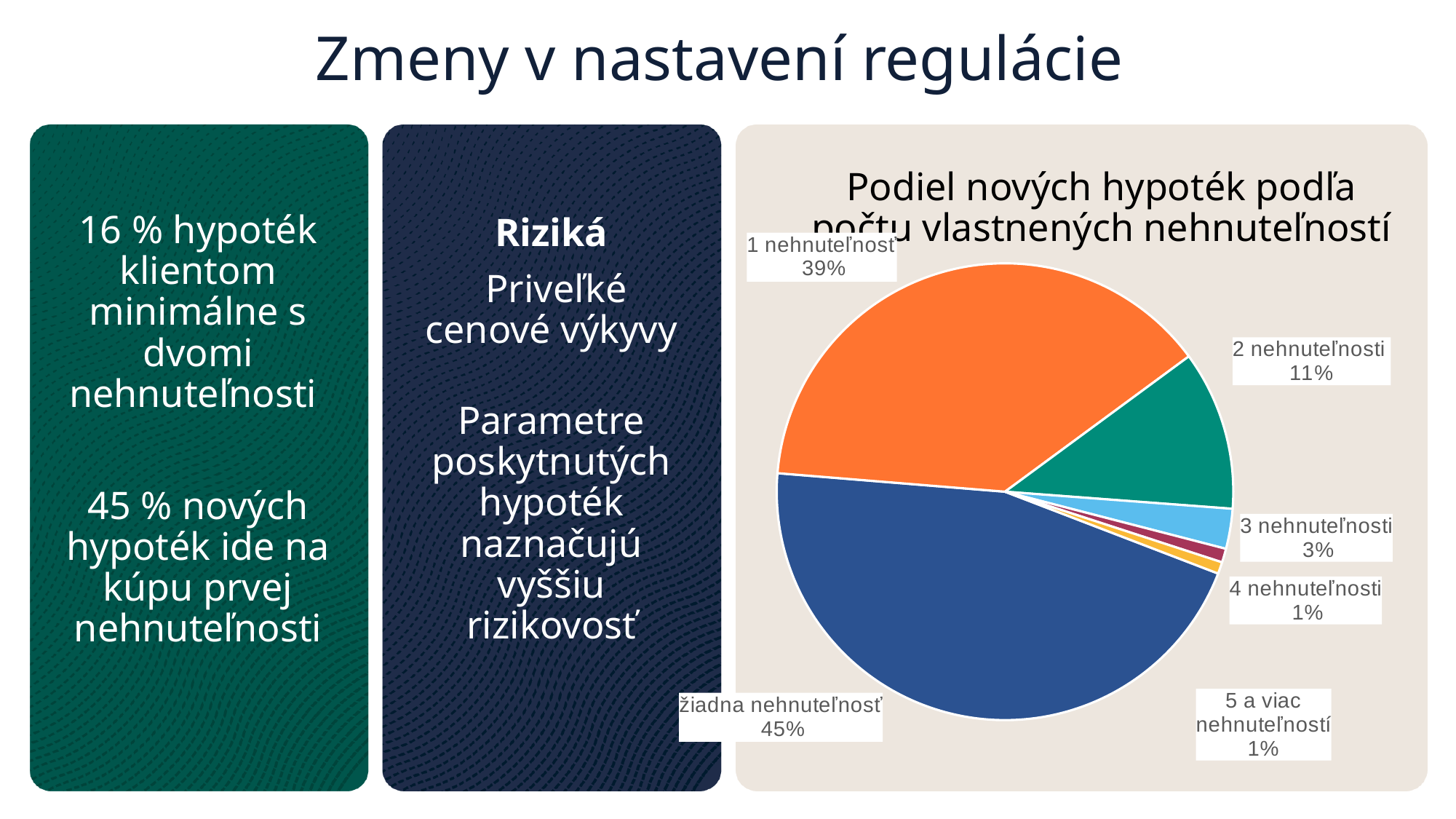
What share of the pie is labelled "1 nehnuteľnosť"? 39% What colour is the slice for "1 nehnuteľnosť"? Orange Which category has the largest slice of the pie? žiadna nehnuteľnosť What share of the pie is labelled "3 nehnuteľnosti"? 3% What type of chart is shown on the slide? Pie chart What share of the pie is labelled "2 nehnuteľnosti"? 11% What is the title of the chart? Podiel nových hypoték podľa počtu vlastnených nehnuteľností How many slices does the pie chart have? 6 What is the difference in percentage points between "žiadna nehnuteľnosť" and "1 nehnuteľnosť"? 6 percentage points Which is larger, the share for "2 nehnuteľnosti" or the share for "3 nehnuteľnosti"? 2 nehnuteľnosti